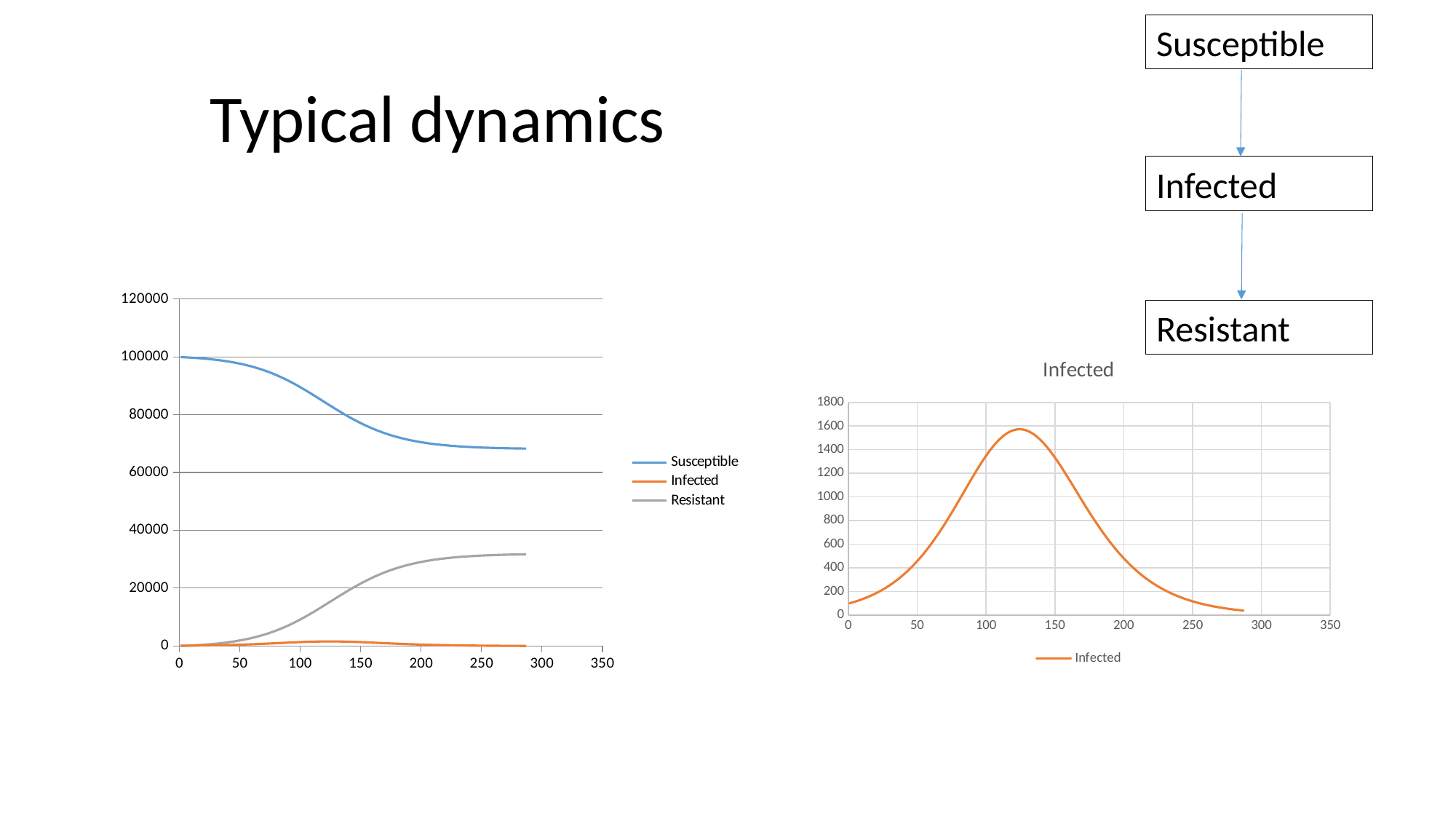
What kind of chart is the left chart on the slide? line chart How many series does the legend of the left chart list? 3 In the left chart, is the value of the Susceptible series at x = 250 greater or less than 80000? less How many series does the legend of the right chart titled 'Infected' list? 1 In the left chart, which is larger at x = 250: the Susceptible series or the Resistant series? Susceptible In the left chart, is the value of the Resistant series at x = 250 greater or less than 20000? greater In the left chart, does the Susceptible series rise or fall along the x axis? fall In the left chart, which series has the highest value at x = 0? Susceptible In the left chart, does the Resistant series rise or fall along the x axis? rise In the right chart titled 'Infected', is the value at x = 250 greater or less than 200? less